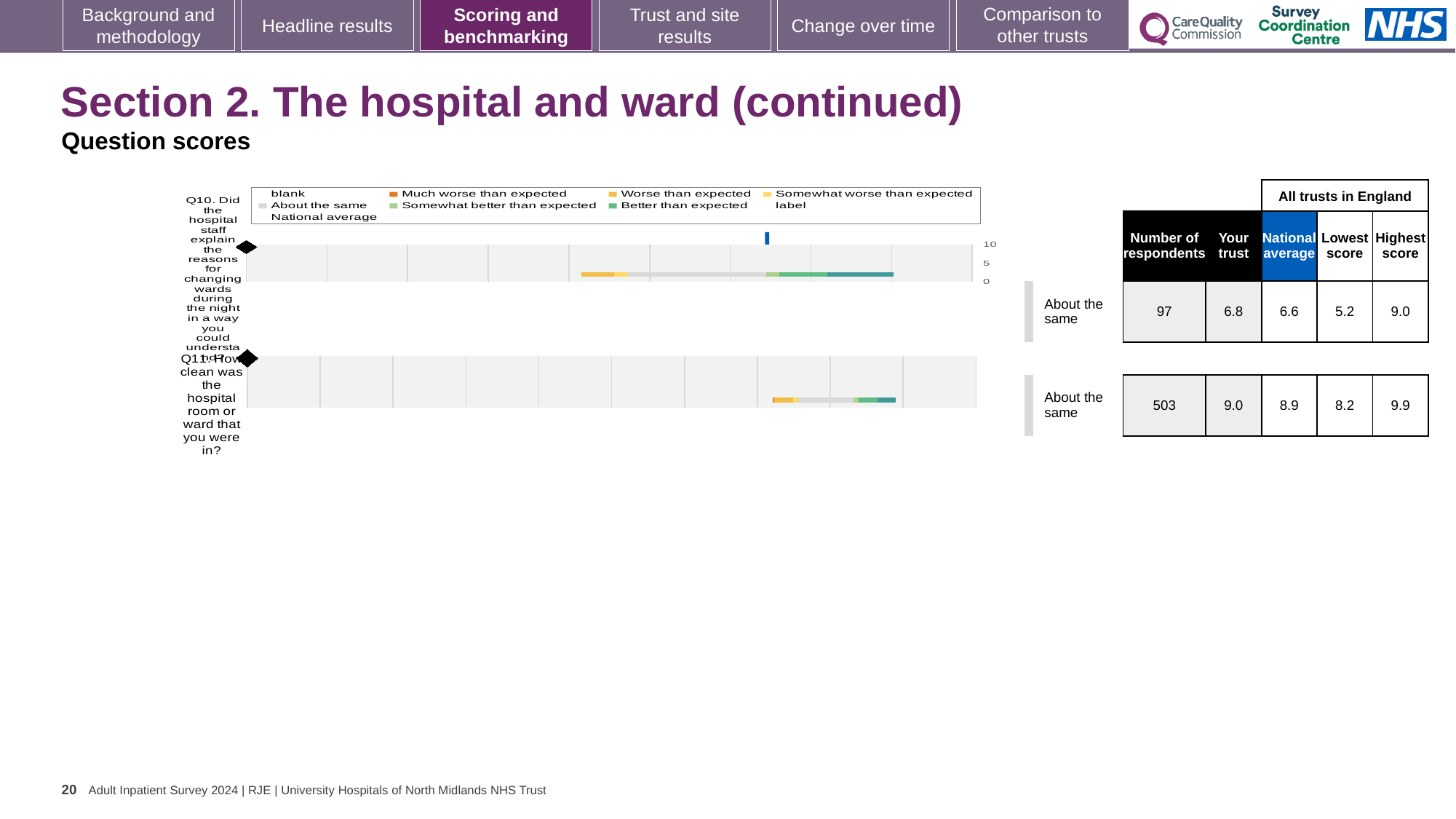
For Q10, which is higher: the 'Your trust' score or the national average? Your trust What kind of chart is used to show the Q10 and Q11 question scores? Bar chart For Q10, by how much does the 'Your trust' score exceed the national average? 0.2 What benchmark category is shown next to the Q11 chart? About the same For Q11, what is the highest score among all trusts in England? 9.9 For Q10 (explaining reasons for changing wards during the night), what is the 'Your trust' score? 6.8 For Q11 (how clean was the hospital room or ward), what is the 'Your trust' score? 9.0 For Q11, what is the difference between the highest score (9.9) and the lowest score (8.2) among all trusts in England? 1.7 For Q10, what is the national average score? 6.6 How many respondents answered Q10? 97 Which legend entry is shown in dark orange? Much worse than expected How many survey questions (Q10, Q11, ...) are plotted on this slide? 2